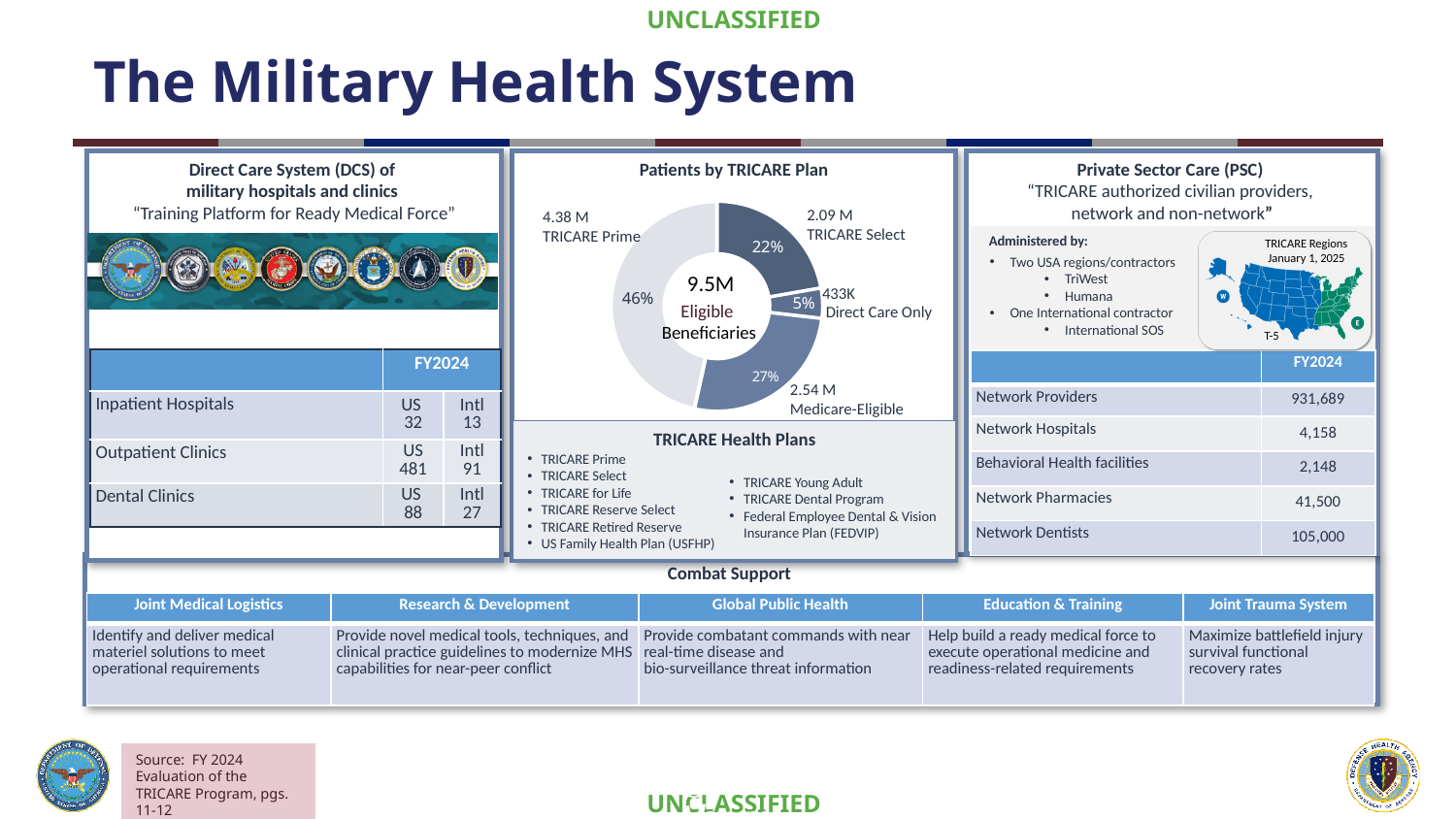
In the "Patients by TRICARE Plan" chart, what percentage share does Direct Care Only have? 5% In the "Patients by TRICARE Plan" chart, how many slices are shown? 4 What kind of chart is "Patients by TRICARE Plan"? Donut (pie) chart What total number of eligible beneficiaries is shown in the center of the "Patients by TRICARE Plan" chart? 9.5M In the "Patients by TRICARE Plan" chart, what percentage share does TRICARE Prime have? 46% In the "Patients by TRICARE Plan" chart, what percentage share is Medicare-Eligible? 27% In the "Patients by TRICARE Plan" chart, which category has the largest share? TRICARE Prime In the "Patients by TRICARE Plan" chart, which is larger: TRICARE Select or Medicare-Eligible? Medicare-Eligible In the "Patients by TRICARE Plan" chart, how many beneficiaries are Direct Care Only? 433K In the "Patients by TRICARE Plan" chart, how many beneficiaries are in TRICARE Select? 2.09 M In the "Patients by TRICARE Plan" chart, what is the difference in percentage points between TRICARE Prime and TRICARE Select? 24 percentage points In the "Patients by TRICARE Plan" chart, which category has the smallest share? Direct Care Only